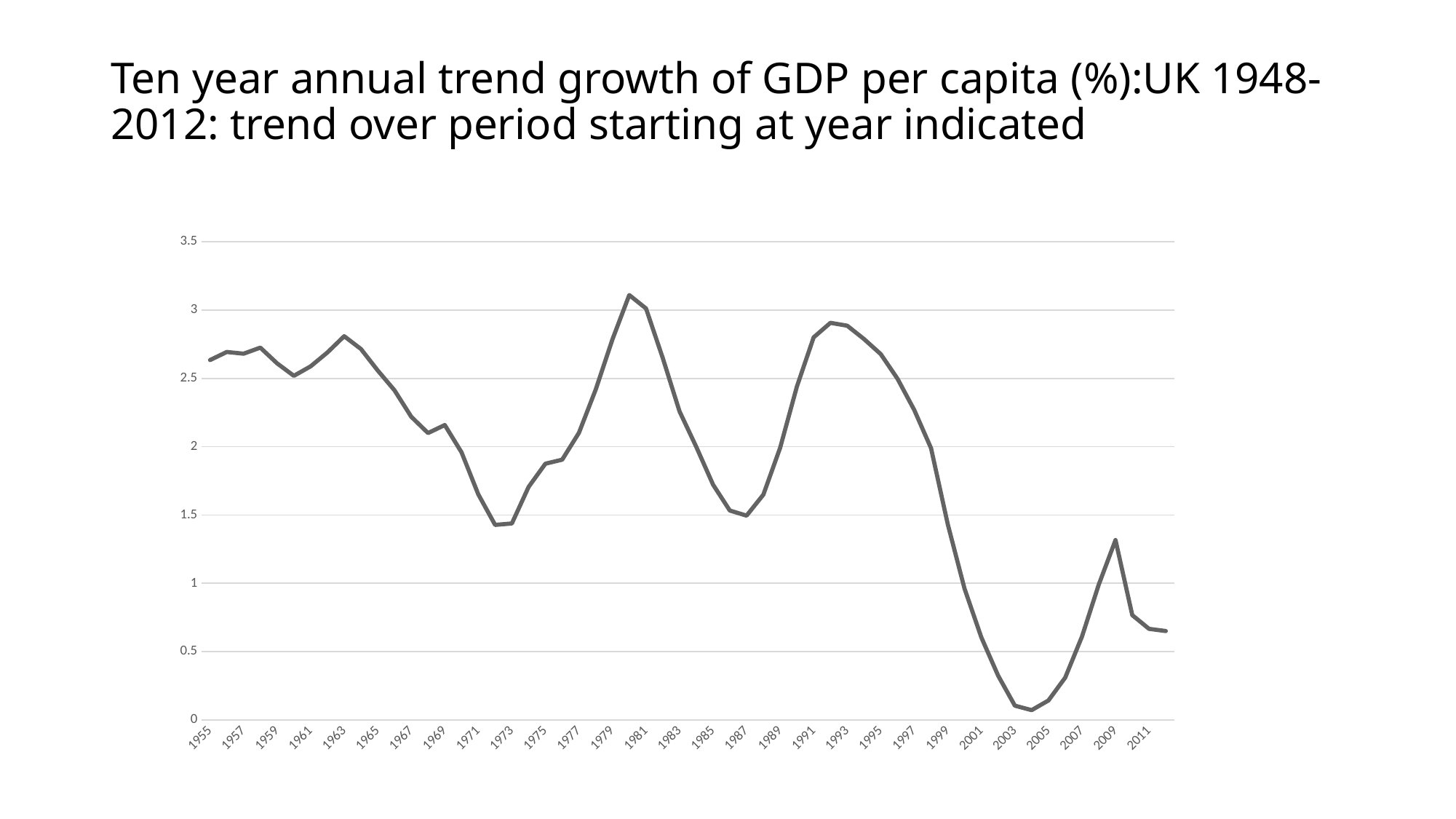
Is the value for 1987 greater or less than 2? less What is the title of the chart? Ten year annual trend growth of GDP per capita (%):UK 1948-2012: trend over period starting at year indicated What kind of chart is shown on the slide? line chart Does the line rise or fall between 1987 and 1992? rise Is the value for 1955 greater or less than 2.5? greater Is the value for 2004 greater or less than 0.5? less Which year has the larger value, 1963 or 1972? 1963 In which year does the line reach its lowest value? 2004 Does the line rise or fall between 1999 and 2004? fall In which year does the line reach its highest value? 1980